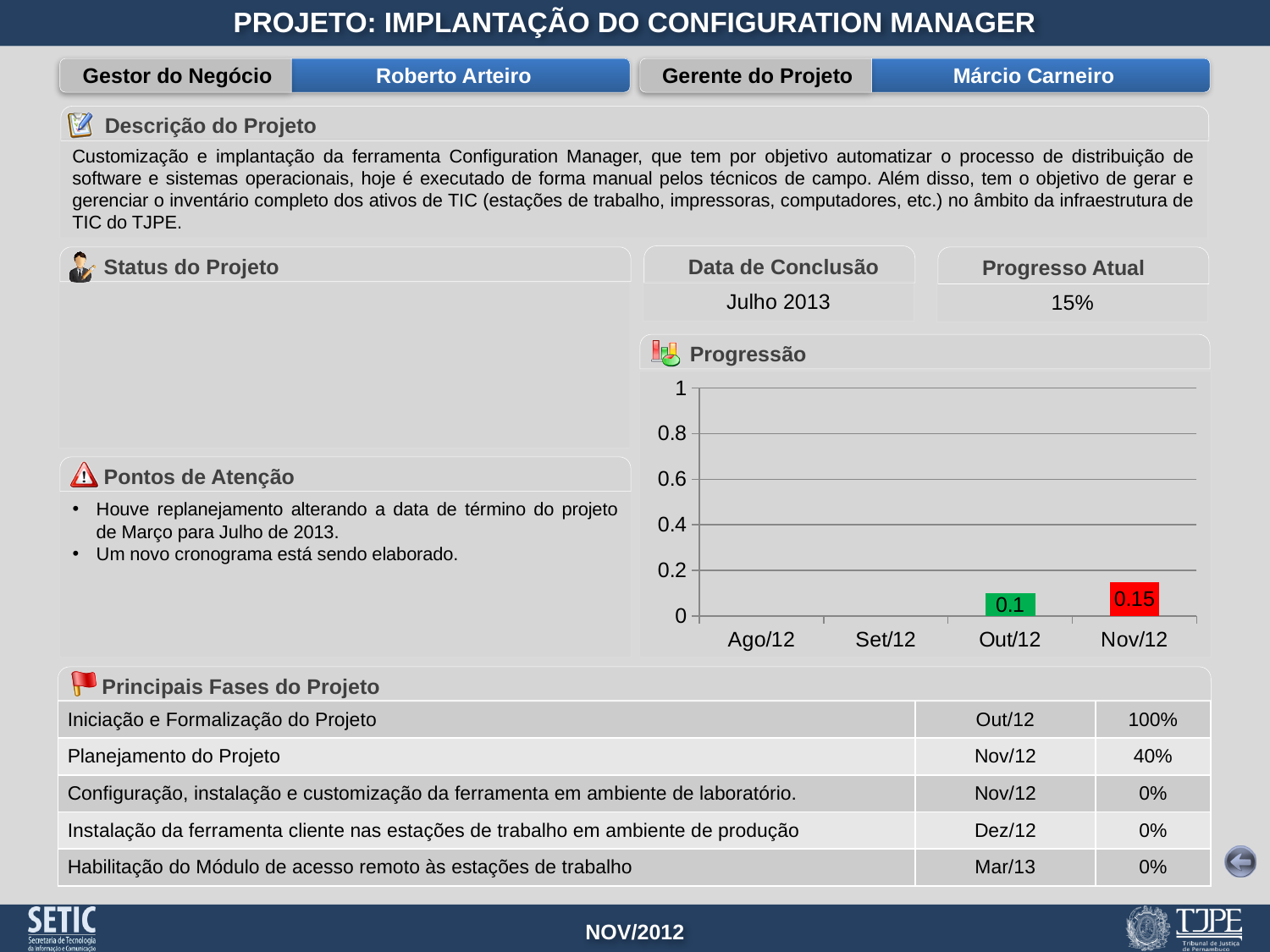
In the Progressão chart, what is the difference between the values for Nov/12 and Out/12? 0.05 In the Progressão chart, which month has the highest value? Nov/12 In the Progressão chart, do the values rise or fall from Out/12 to Nov/12? rise In the Progressão chart, what colour is the bar for Nov/12? red In the Progressão chart, is the value for Out/12 greater or less than 0.4? less In the Progressão chart, what is the value for Nov/12? 0.15 In the Progressão chart, which is larger, the value for Out/12 or the value for Nov/12? Nov/12 How many months are shown on the x axis of the Progressão chart? 4 How many bars with data labels are shown in the Progressão chart? 2 What kind of chart is the Progressão chart? bar chart In the Progressão chart, is the value for Nov/12 greater or less than 0.2? less In the Progressão chart, what is the value for Out/12? 0.1